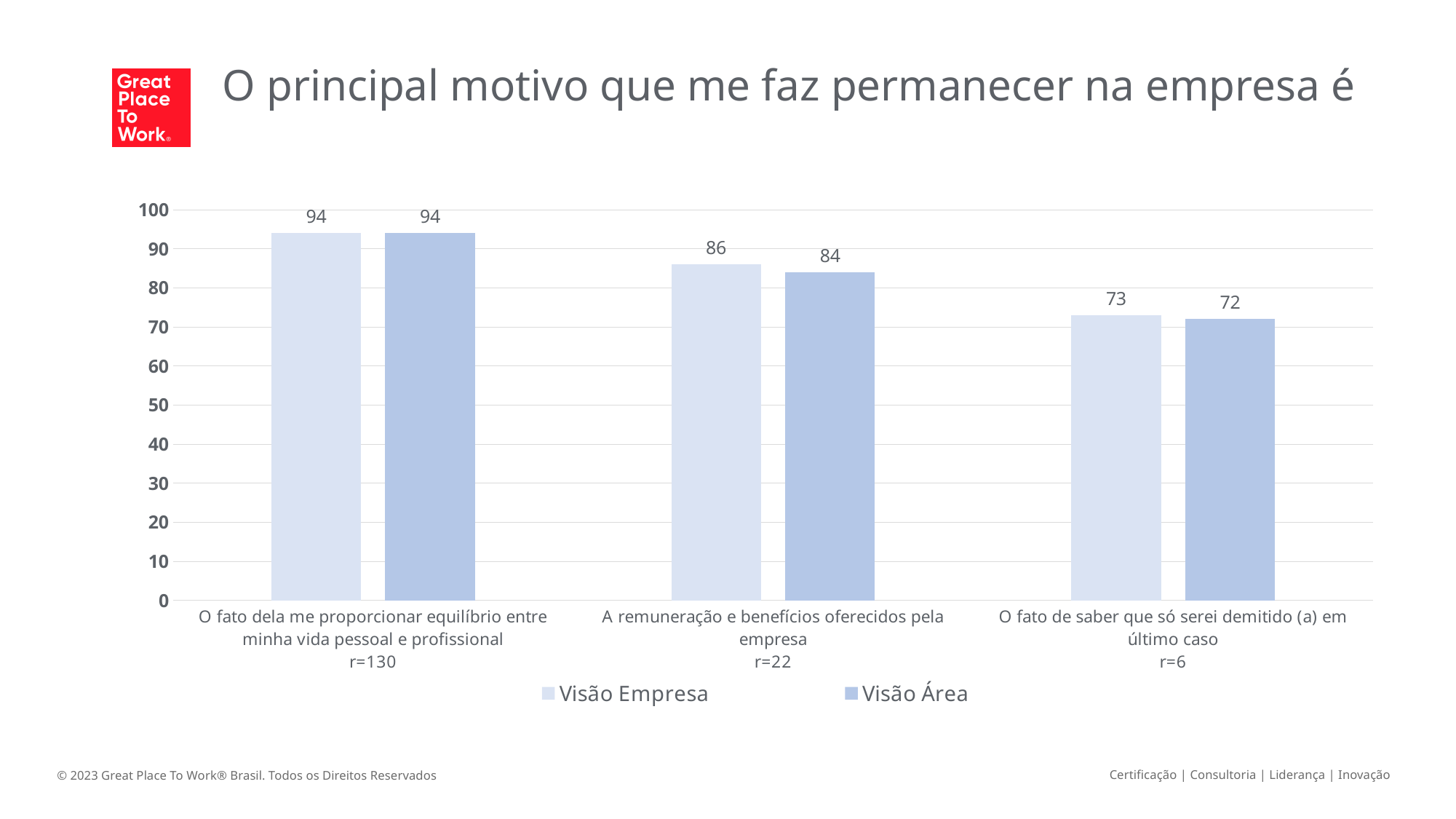
How many categories are shown on the x axis? 3 Which category has the highest Visão Empresa value? O fato dela me proporcionar equilíbrio entre minha vida pessoal e profissional What is the Visão Empresa value for 'O fato dela me proporcionar equilíbrio entre minha vida pessoal e profissional'? 94 What is the Visão Área value for 'A remuneração e benefícios oferecidos pela empresa'? 84 How many series does the legend list? 2 What is the difference between the Visão Empresa values for 'O fato dela me proporcionar equilíbrio entre minha vida pessoal e profissional' and 'O fato de saber que só serei demitido (a) em último caso'? 21 Which category has the lowest Visão Área value? O fato de saber que só serei demitido (a) em último caso What is the title of the slide? O principal motivo que me faz permanecer na empresa é Which is larger: the Visão Empresa value for 'A remuneração e benefícios oferecidos pela empresa' or the Visão Área value for 'O fato de saber que só serei demitido (a) em último caso'? Visão Empresa value for 'A remuneração e benefícios oferecidos pela empresa' What kind of chart is shown on the slide? Bar chart What is the Visão Empresa value for 'O fato de saber que só serei demitido (a) em último caso'? 73 What is the difference between the Visão Empresa and Visão Área values for 'A remuneração e benefícios oferecidos pela empresa'? 2